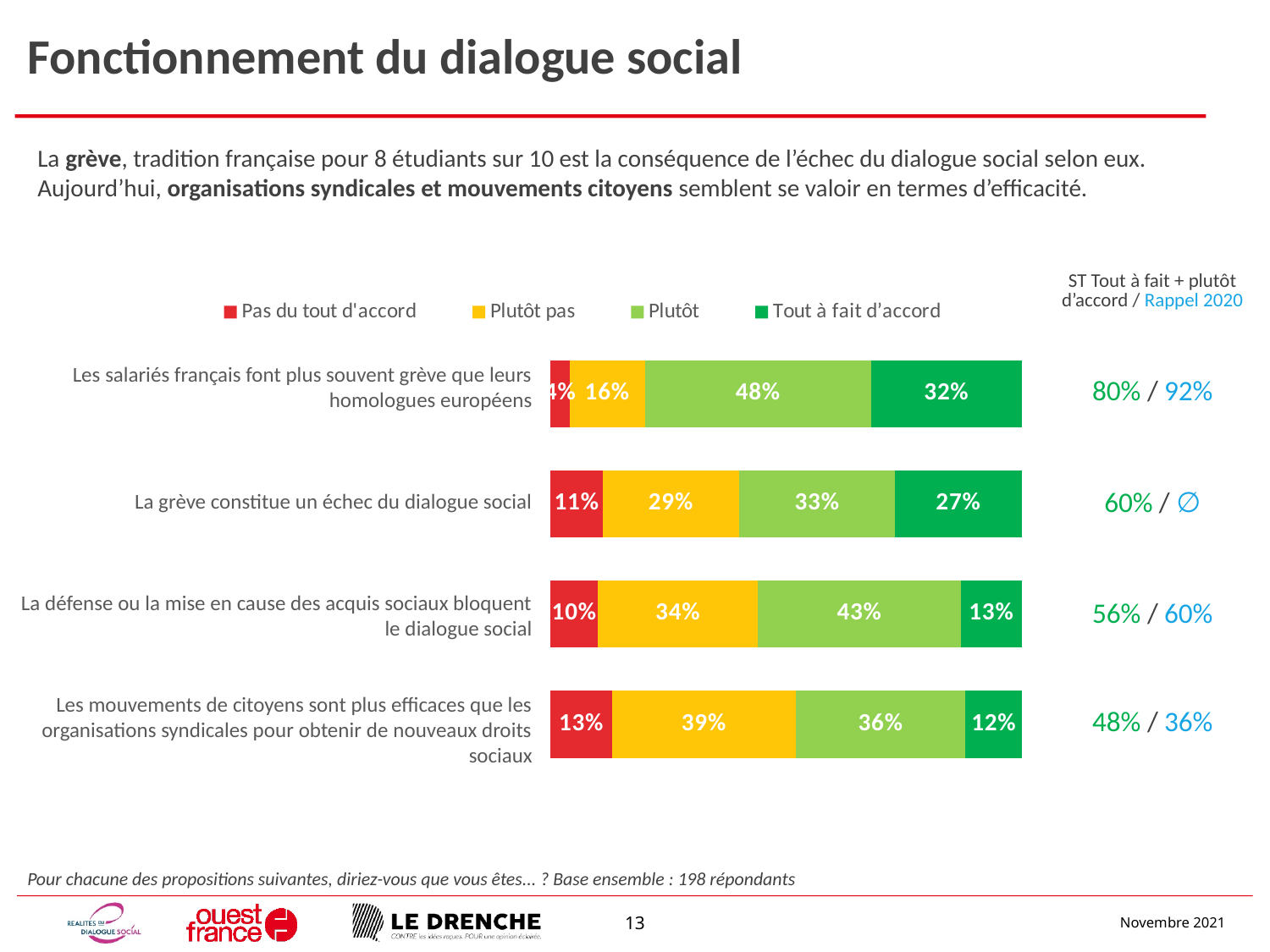
Which proposition has the highest 'Plutôt' value? Les salariés français font plus souvent grève que leurs homologues européens How many propositions (categories) are plotted in the chart? 4 What is the 'Tout à fait d'accord' value for 'Les salariés français font plus souvent grève que leurs homologues européens'? 32% What is the 'Plutôt' value for 'La défense ou la mise en cause des acquis sociaux bloquent le dialogue social'? 43% What colour represents 'Pas du tout d'accord' in the legend? red What kind of chart is shown on the slide? stacked bar chart What is the 'Pas du tout d'accord' value for 'Les mouvements de citoyens sont plus efficaces que les organisations syndicales pour obtenir de nouveaux droits sociaux'? 13% What is the difference between the 'Plutôt pas' values for 'Les mouvements de citoyens sont plus efficaces...' and 'La grève constitue un échec du dialogue social'? 10% Which is larger: the 'Tout à fait d'accord' value for 'La grève constitue un échec du dialogue social' or for 'La défense ou la mise en cause des acquis sociaux bloquent le dialogue social'? La grève constitue un échec du dialogue social How many series does the legend list? 4 What is the 'Plutôt pas' value for 'La grève constitue un échec du dialogue social'? 29% Which proposition has the lowest 'Tout à fait d'accord' value? Les mouvements de citoyens sont plus efficaces que les organisations syndicales pour obtenir de nouveaux droits sociaux